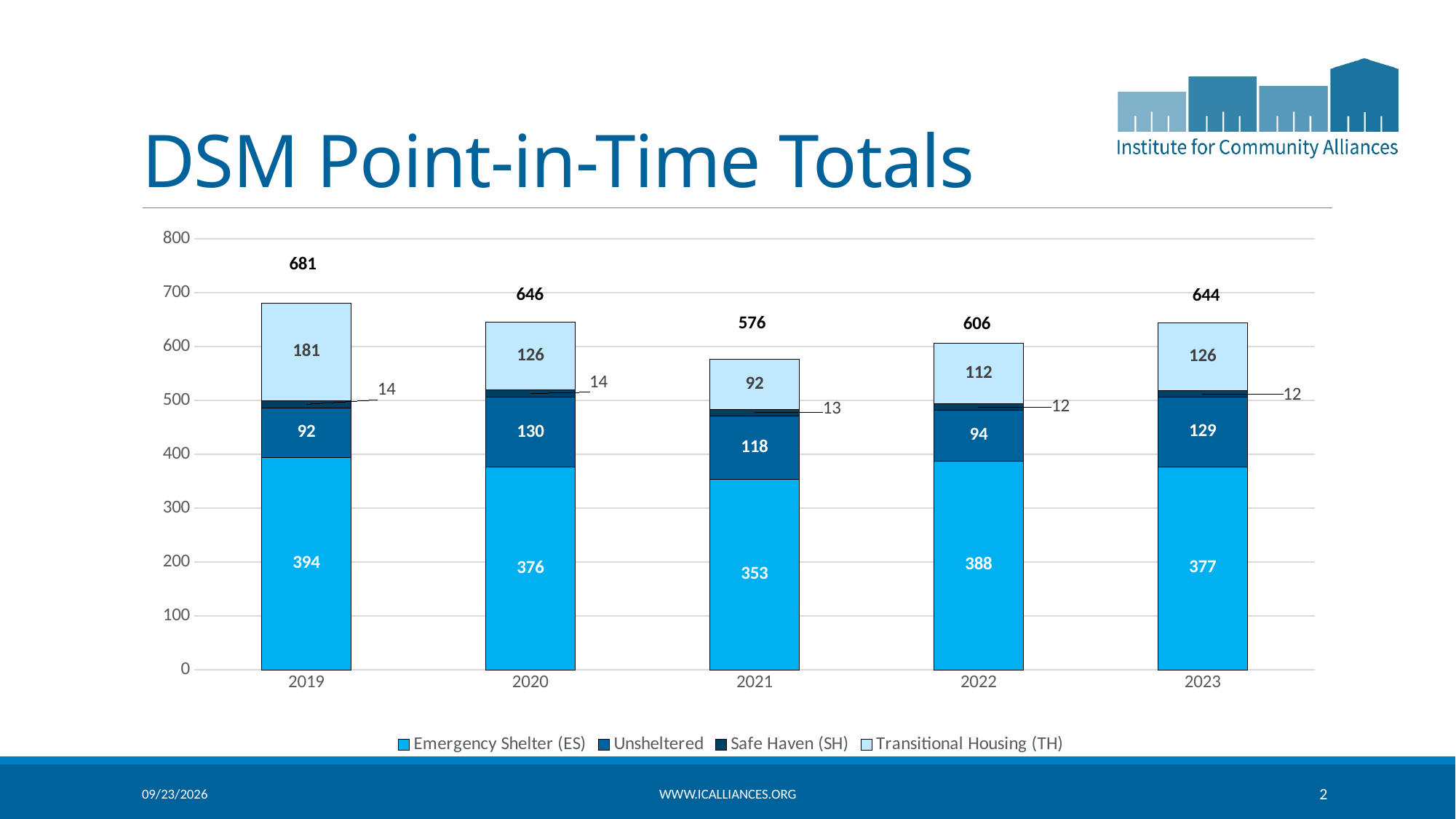
What is the title of the chart? DSM Point-in-Time Totals What type of chart is shown on the slide? Stacked bar chart What is the difference between the Unsheltered values for 2020 and 2019? 38 Which is larger, the Transitional Housing (TH) value for 2022 or for 2023? 2023 How many series does the legend list? 4 What is the Transitional Housing (TH) value for 2019? 181 Which year has the highest total? 2019 What is the Safe Haven (SH) value for 2023? 12 What is the total of the stacked bar for 2022? 606 What is the Emergency Shelter (ES) value for 2021? 353 How many years are shown on the x axis? 5 Which year has the lowest total? 2021